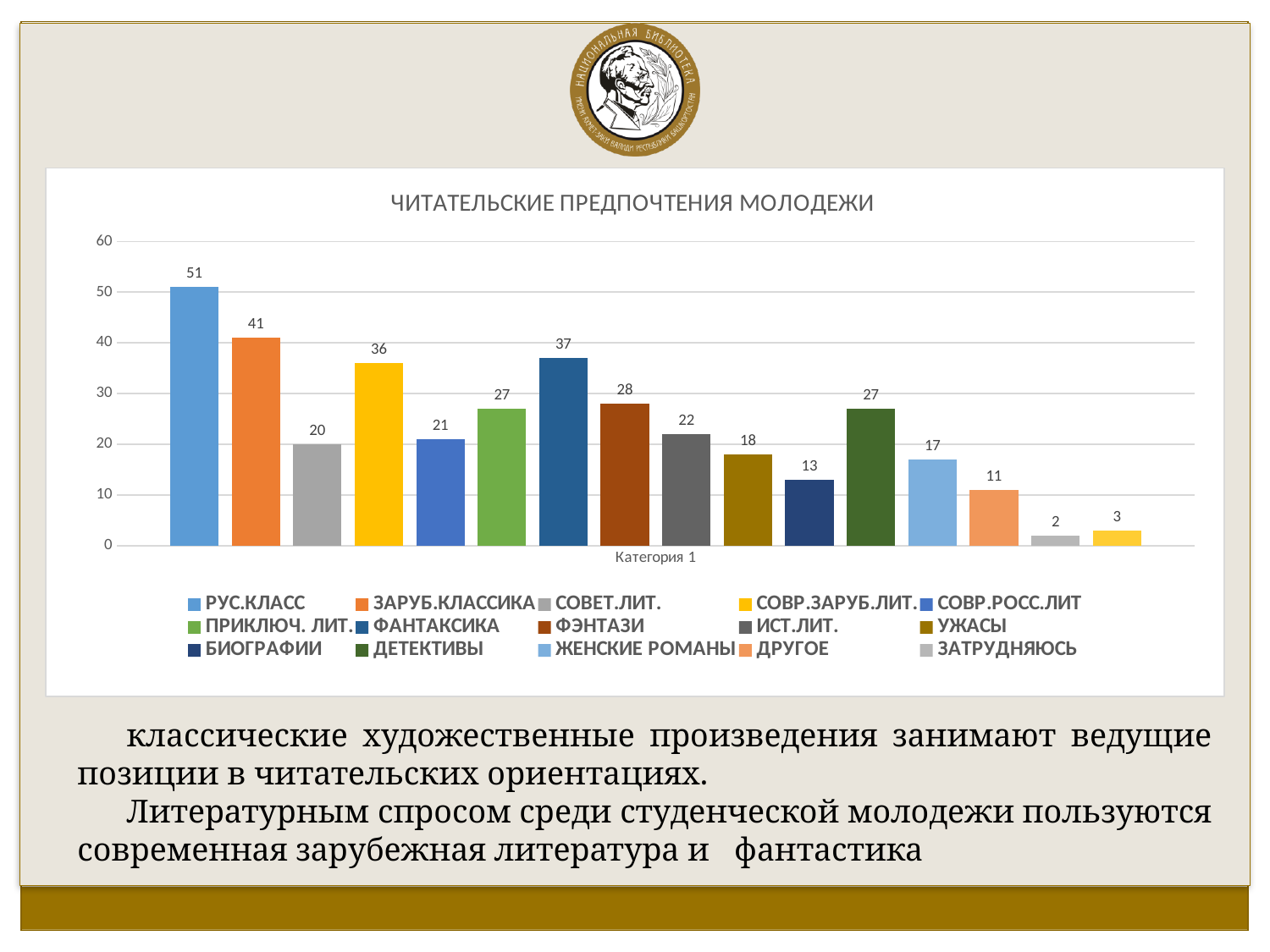
What is the title of the chart? ЧИТАТЕЛЬСКИЕ ПРЕДПОЧТЕНИЯ МОЛОДЕЖИ What is the value for БИОГРАФИИ? 13 Which series has the highest value? РУС.КЛАСС What type of chart is shown on the slide? bar chart Which series has the lowest value? ЗАТРУДНЯЮСЬ What is the difference between the values for РУС.КЛАСС and ЗАРУБ.КЛАССИКА? 10 Which is larger, the value for СОВР.ЗАРУБ.ЛИТ. or the value for ФЭНТАЗИ? СОВР.ЗАРУБ.ЛИТ. How many series does the legend list? 15 What is the value for РУС.КЛАСС? 51 What is the value for ФАНТАКСИКА? 37 What is the difference between the values for ИСТ.ЛИТ. and УЖАСЫ? 4 What is the value for ЖЕНСКИЕ РОМАНЫ? 17